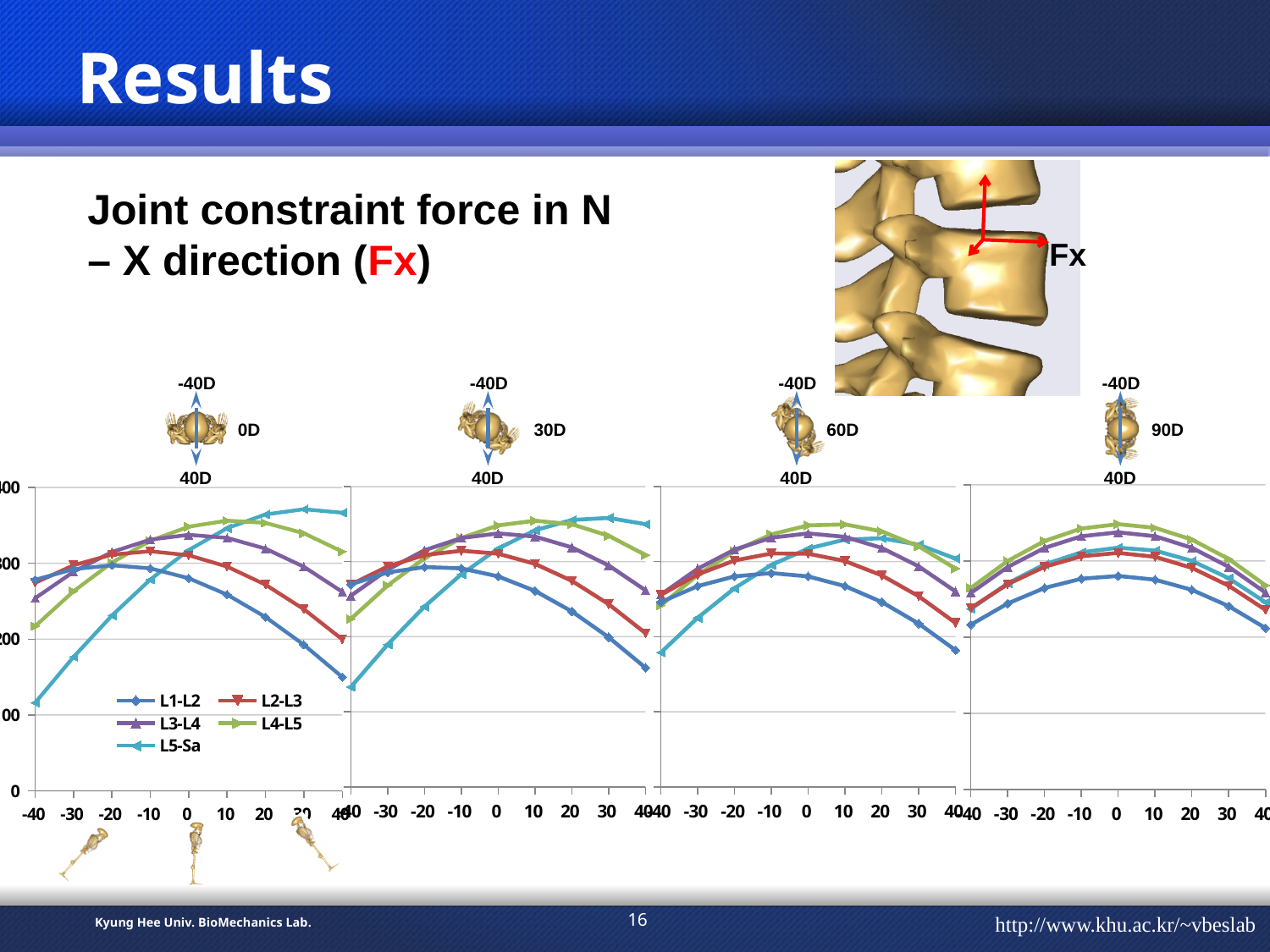
In the 0D chart, is the value for L5-Sa at x = 30 greater or less than 300? greater In the 0D chart, is the value for L1-L2 at x = 40 greater or less than 200? less In the 0D chart, is the value for L5-Sa at x = -40 greater or less than 200? less How many x-axis tick values are shown on the 0D chart? 9 In the 0D chart, which series has the highest value at x = 40? L5-Sa In the 0D chart, which is larger at x = -40: L1-L2 or L5-Sa? L1-L2 In the 0D chart, which series has the lowest value at x = 40? L1-L2 How many line charts are shown on the slide? 4 How many series does the legend in the 0D chart list? 5 What kind of chart is the 0D chart on the left? line chart In the 0D chart, does the L5-Sa series rise or fall from x = -40 to x = 30? rise